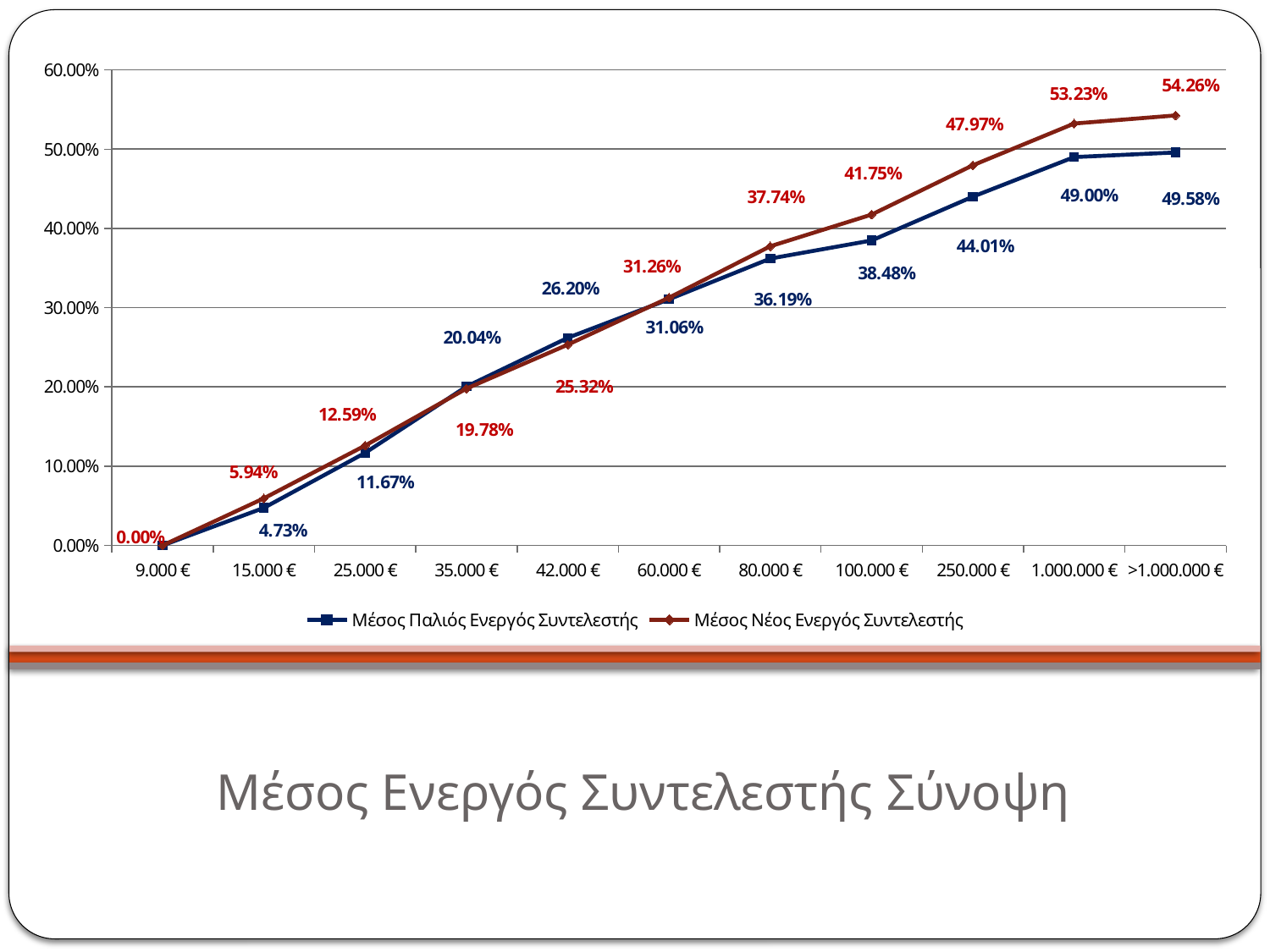
Which category has the highest value for Μέσος Νέος Ενεργός Συντελεστής? >1.000.000 € What colour is the line for Μέσος Νέος Ενεργός Συντελεστής? red What is the value of Μέσος Νέος Ενεργός Συντελεστής at 35.000 €? 19.78% What type of chart is shown on the slide? line chart What is the difference between Μέσος Νέος Ενεργός Συντελεστής and Μέσος Παλιός Ενεργός Συντελεστής at 1.000.000 €? 4.23% How many series does the legend list? 2 What is the value of Μέσος Νέος Ενεργός Συντελεστής at 100.000 €? 41.75% Do the values of Μέσος Παλιός Ενεργός Συντελεστής rise or fall along the x axis? rise At 42.000 €, which series has the larger value, Μέσος Παλιός Ενεργός Συντελεστής or Μέσος Νέος Ενεργός Συντελεστής? Μέσος Παλιός Ενεργός Συντελεστής How many categories are shown on the x axis? 11 What is the difference between Μέσος Νέος Ενεργός Συντελεστής at >1.000.000 € and at 1.000.000 €? 1.03% What is the value of Μέσος Παλιός Ενεργός Συντελεστής at 250.000 €? 44.01%